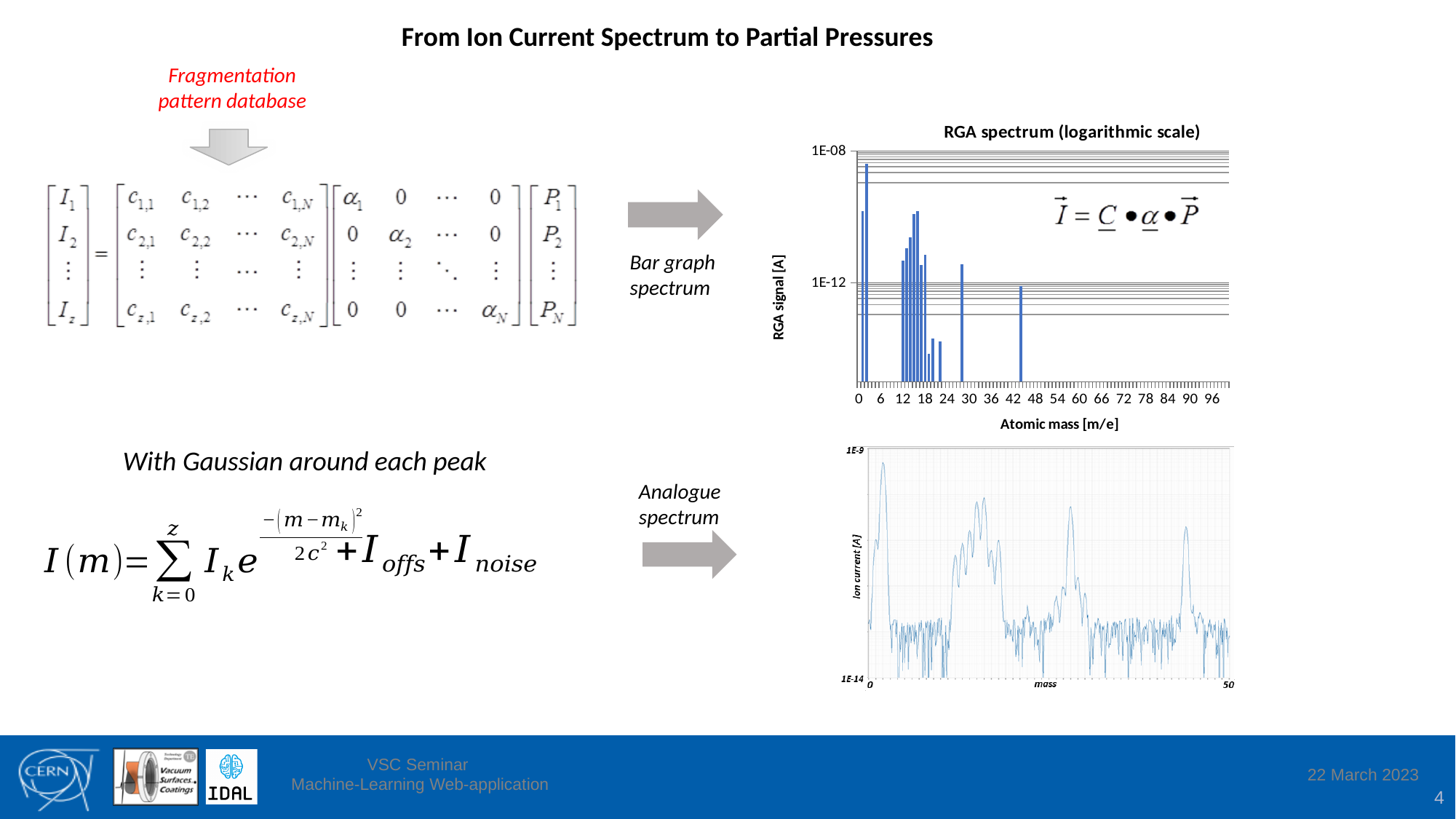
In the 'RGA spectrum (logarithmic scale)' chart, is the tallest bar greater or less than 1E-08? less What kind of chart is the 'RGA spectrum (logarithmic scale)' chart? Bar chart In the 'RGA spectrum (logarithmic scale)' chart, is the tallest bar greater or less than 1E-12? greater In the analogue spectrum chart at the bottom right, what is the lowest value labelled on the y-axis? 1E-14 In the 'RGA spectrum (logarithmic scale)' chart, is the tallest bar located below or above atomic mass 6? below What kind of chart is the analogue spectrum chart at the bottom right of the slide? Line chart In the 'RGA spectrum (logarithmic scale)' chart, what is the highest value labelled on the y-axis? 1E-08 In the 'RGA spectrum (logarithmic scale)' chart, what is the largest atomic mass tick label shown on the x-axis? 96 In the 'RGA spectrum (logarithmic scale)' chart, is the bar near atomic mass 44 taller or shorter than the bar near atomic mass 28? shorter In the 'RGA spectrum (logarithmic scale)' chart, what is the x-axis title? Atomic mass [m/e] In the analogue spectrum chart at the bottom right, what is the maximum value labelled on the x-axis? 50 What is the title of the bar chart on the upper right of the slide? RGA spectrum (logarithmic scale)